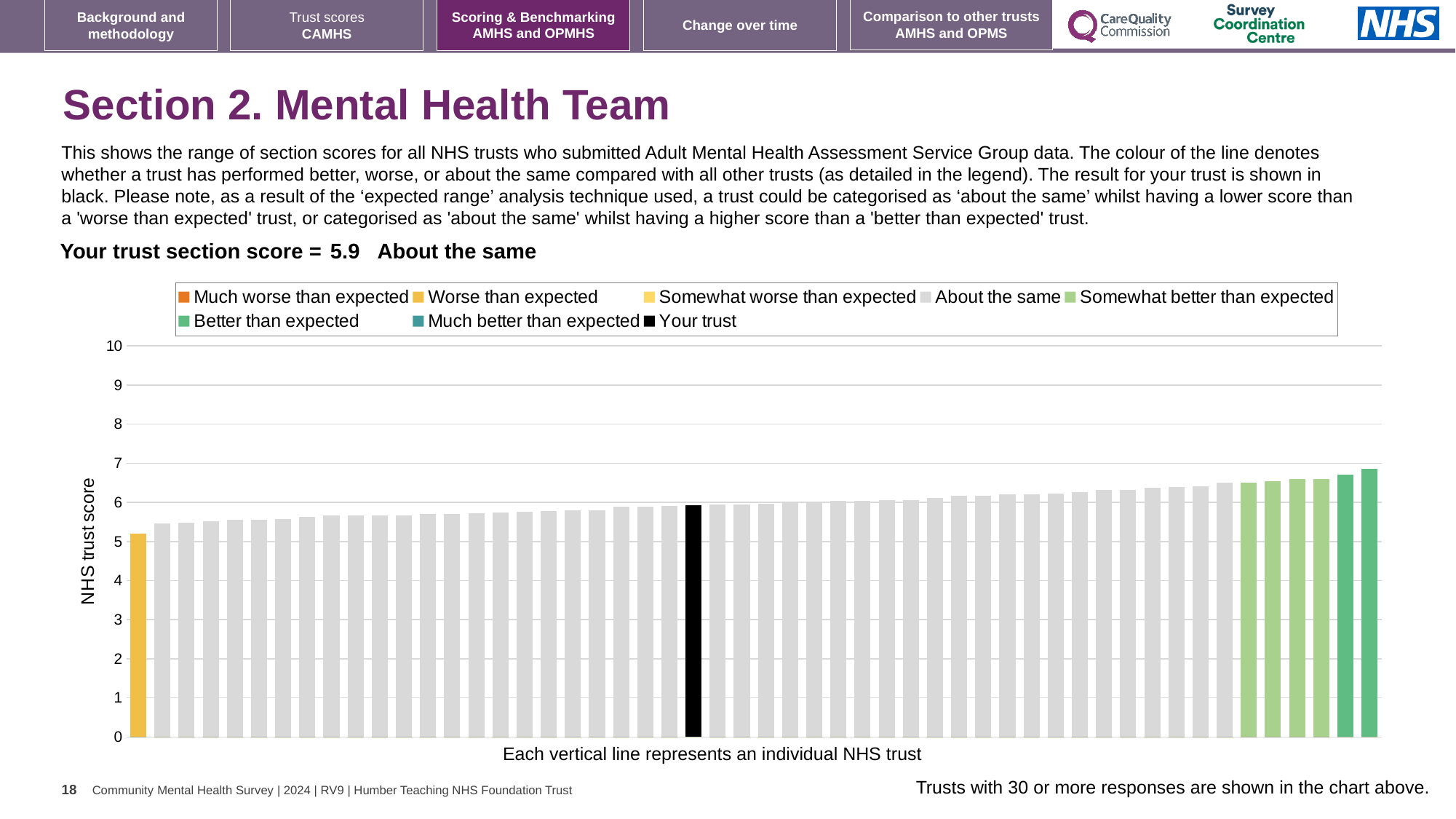
What is the section score for your trust shown on the slide? 5.9 What kind of chart is shown on the slide? Bar chart Is the value of the rightmost bar greater or less than 7? less How many entries does the chart legend list? 8 Which legend category does the lowest bar in the chart belong to? Worse than expected What is the label on the vertical axis of the chart? NHS trust score Which is larger: the value of the leftmost bar or the value of the rightmost bar? The rightmost bar Is the value for your trust (the black bar) greater or less than 5? greater How many bars are coloured as 'Somewhat better than expected'? 4 Do the bar values rise or fall from left to right along the x axis? rise How many bars are coloured as 'Better than expected'? 2 Is the value of the leftmost (yellow) bar greater or less than 6? less